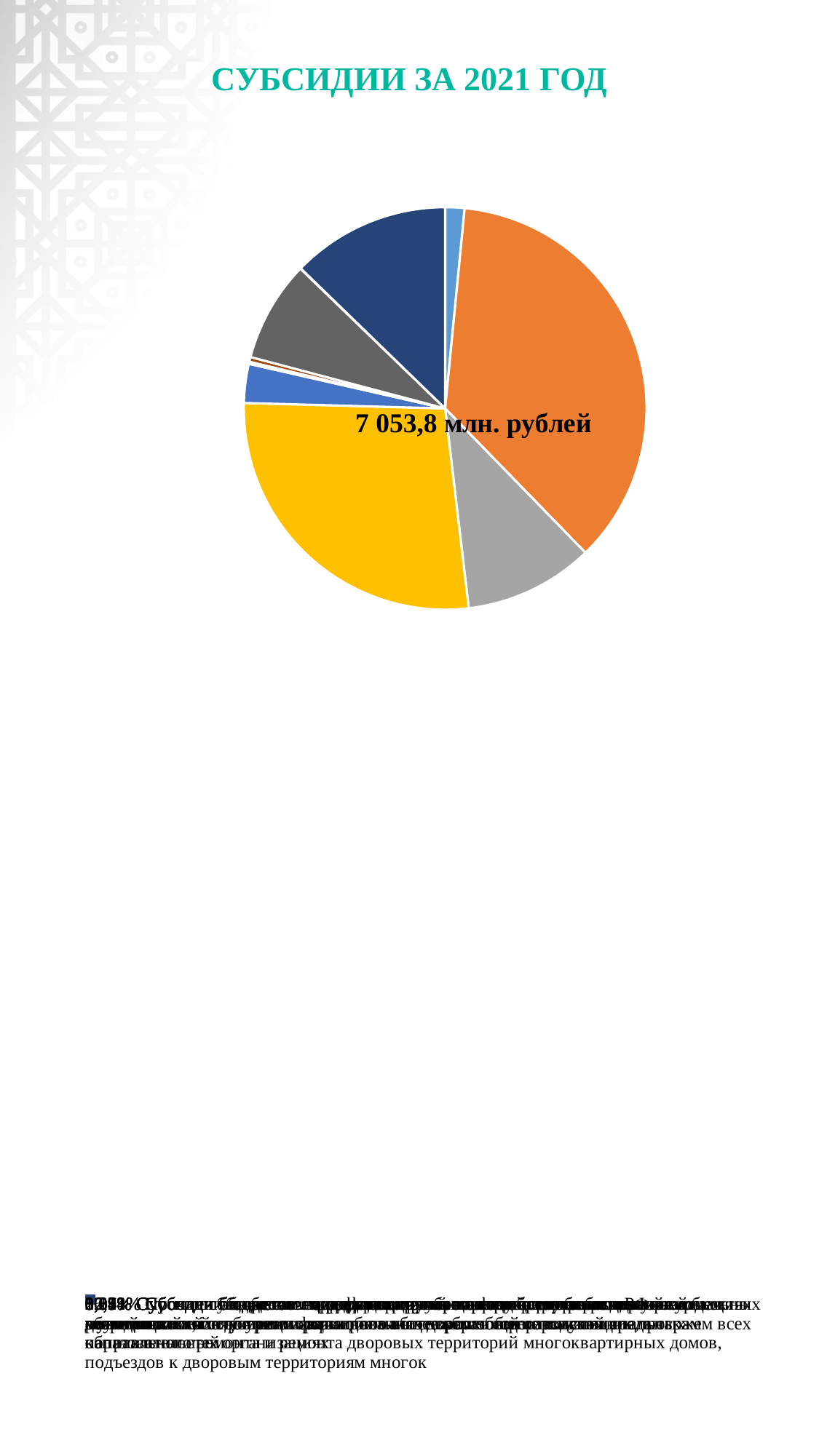
Which is larger in the pie chart, the orange slice or the yellow slice? orange In what unit is the total in the centre of the pie chart expressed? млн. рублей Which is larger in the pie chart, the dark blue slice or the light blue slice? dark blue What kind of chart is shown on the slide? pie chart Which is larger in the pie chart, the yellow slice or the light gray slice? yellow Which colour slice of the pie chart is the largest? orange What total amount is printed in the centre of the pie chart? 7 053,8 млн. рублей What is the title of the slide containing the pie chart? СУБСИДИИ ЗА 2021 ГОД